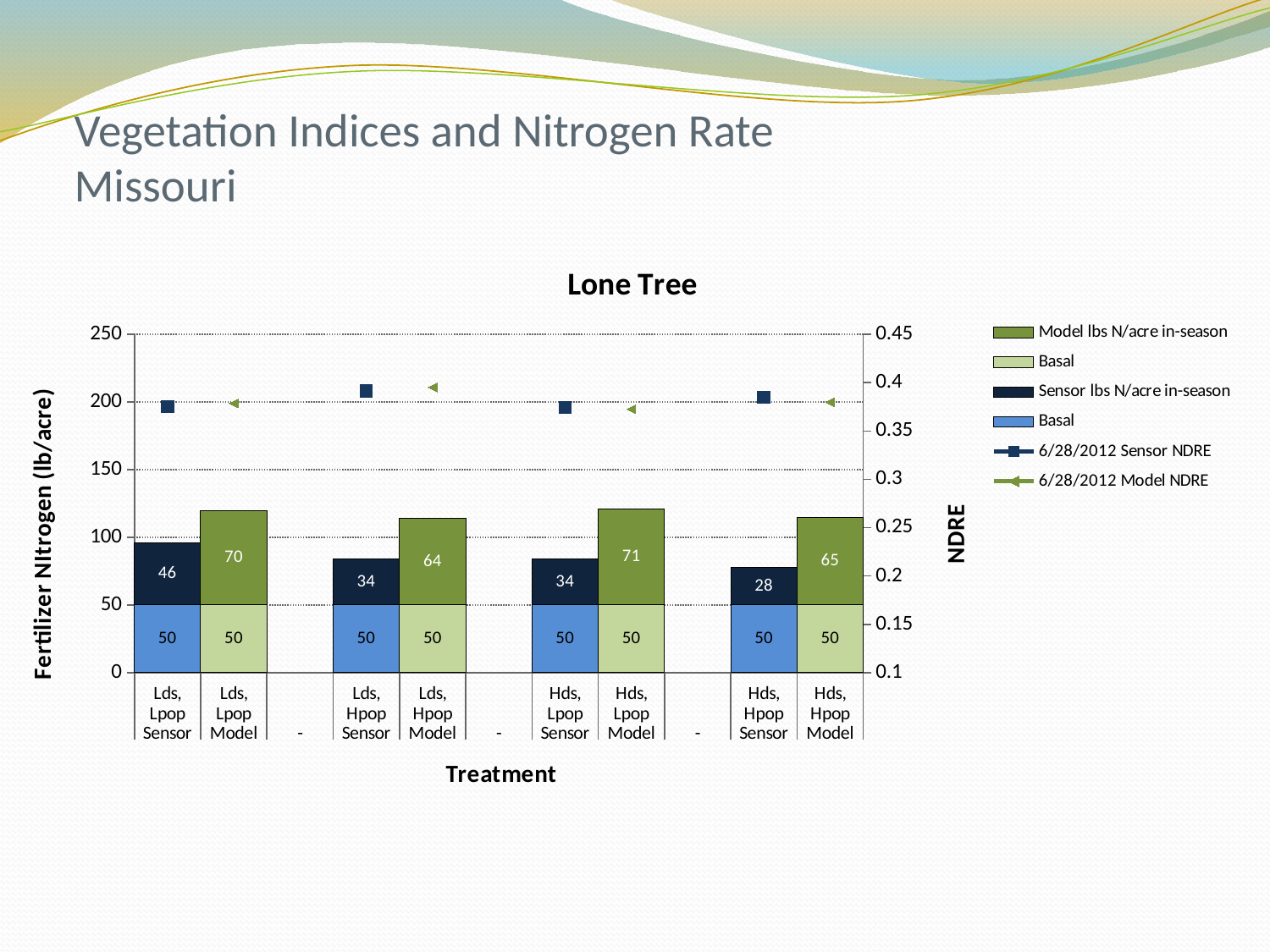
What is the total height of the stacked bar for the Lds, Lpop Model treatment? 120 Which treatment has the lowest Sensor lbs N/acre in-season value? Hds, Hpop Sensor What is the difference between the Model in-season value for Hds, Lpop Model and the Sensor in-season value for Hds, Lpop Sensor? 37 What is the Basal value for the Hds, Hpop Sensor treatment? 50 What is the Sensor lbs N/acre in-season value for the Lds, Lpop Sensor treatment? 46 What is the title of the chart? Lone Tree Which is larger, the Model in-season value for Lds, Hpop Model or for Hds, Hpop Model? Hds, Hpop Model Which treatment has the highest Sensor lbs N/acre in-season value? Lds, Lpop Sensor What kind of chart is used to show the fertilizer nitrogen values? Stacked bar chart How many series does the legend list? 6 What is the Model lbs N/acre in-season value for the Hds, Lpop Model treatment? 71 Is the 6/28/2012 Sensor NDRE value for the Lds, Hpop Sensor treatment greater or less than 0.35? greater